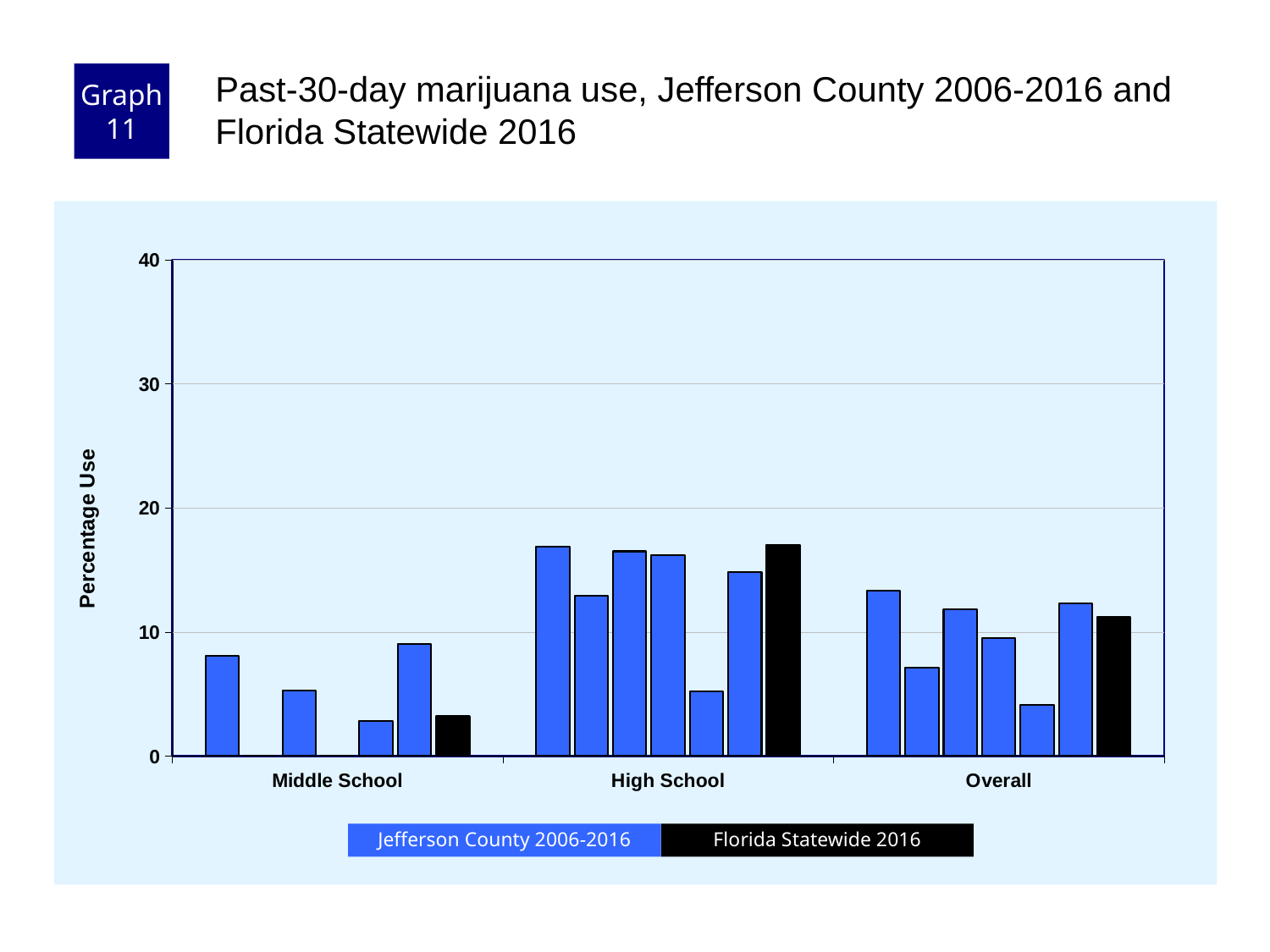
How many school-level categories are shown on the x axis? 3 Which colour represents Florida Statewide 2016 in the chart? black Are all the High School bars greater or less than 20? less Which category has the highest Florida Statewide 2016 value? High School Which category has the lowest Florida Statewide 2016 value? Middle School How many series does the legend list? 2 Is the Florida Statewide 2016 value for High School greater or less than 10? greater What kind of chart is shown on the slide? bar chart Is the Florida Statewide 2016 value larger for High School or for Overall? High School What is the label of the y axis? Percentage Use Is the Florida Statewide 2016 value for High School greater or less than 20? less